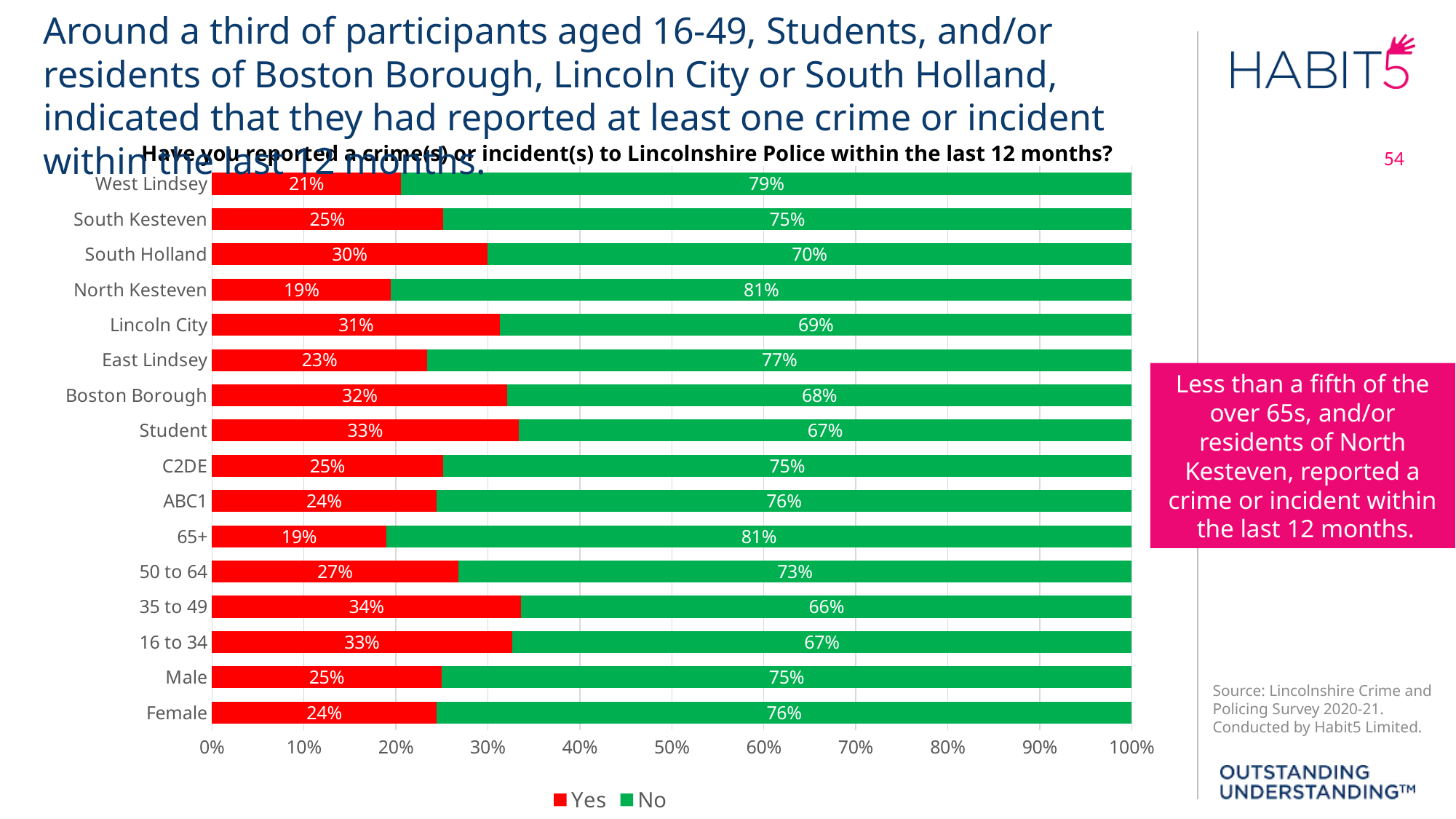
Which category has the highest No percentage? North Kesteven and 65+ Is the Yes value for 50 to 64 greater or less than 30%? less What is the Yes value for Lincoln City? 31% What percentage of North Kesteven residents answered No? 81% What percentage of Students answered Yes? 33% What is the total of the Yes and No values for Female? 100% How many categories are shown on the y axis? 16 Which category has the highest Yes percentage? 35 to 49 What is the difference between the Yes values for Boston Borough and West Lindsey? 11% What kind of chart is shown? Stacked bar chart How many series does the legend list? 2 Which has a larger Yes value, South Holland or South Kesteven? South Holland